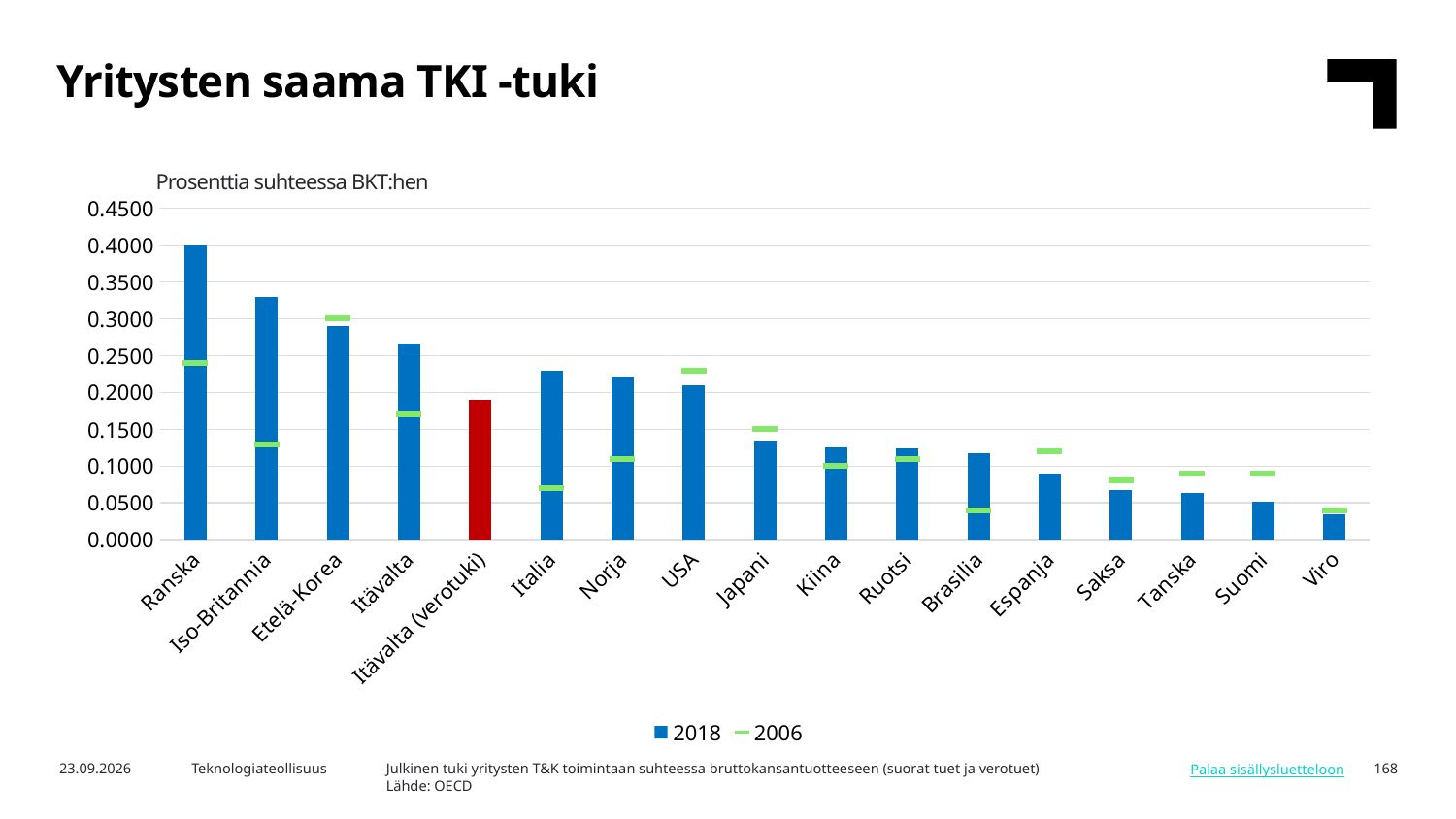
Which category has the lowest 2018 value in the chart? Viro Is the 2018 value for Saksa greater or less than 0.1000? less Which has the larger 2018 value, Ranska or Iso-Britannia? Ranska What kind of chart is shown on the slide? Bar chart Which has the larger 2018 value, Japani or Saksa? Japani Is the 2018 value for Italia greater or less than 0.2000? greater How many series does the chart legend list? 2 Which category is shown with a red bar instead of a blue one? Itävalta (verotuki) Is the 2018 value for Viro greater or less than 0.0500? less Which category has the highest 2018 value in the chart? Ranska How many countries/categories are shown on the x axis of the chart? 17